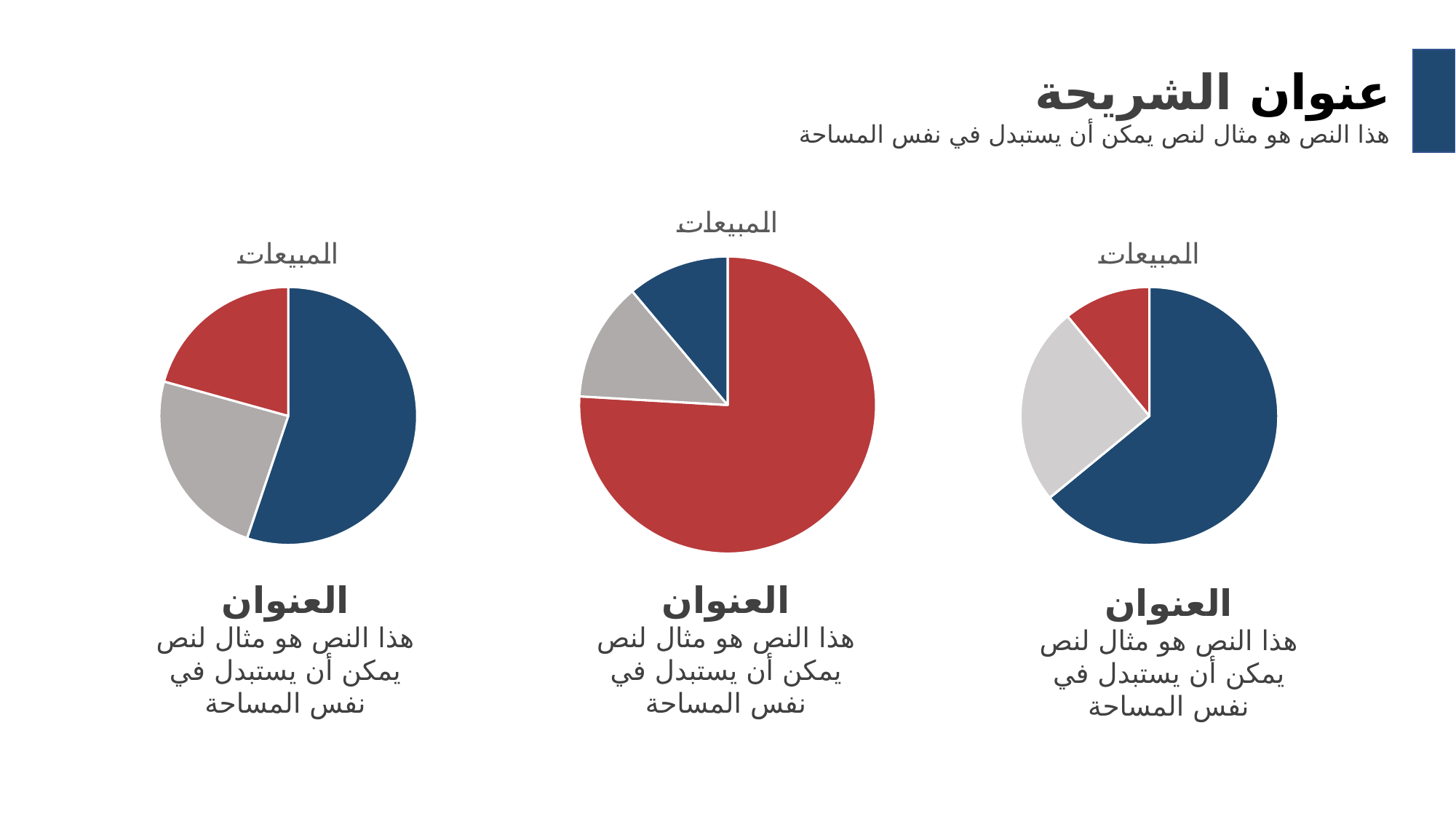
What kind of chart is the right chart on the slide? pie chart In the right pie chart, which colour slice is the largest? blue In the left pie chart, how many slices are there? 3 In the right pie chart, which colour slice is the smallest? red In the left pie chart, which colour slice is the largest? blue In the middle pie chart, which colour slice is the largest? red In the middle pie chart, how many slices are there? 3 What kind of chart is the middle chart on the slide? pie chart In the right pie chart, how many slices are there? 3 What kind of chart is the left chart on the slide? pie chart What is the title of the middle chart? المبيعات